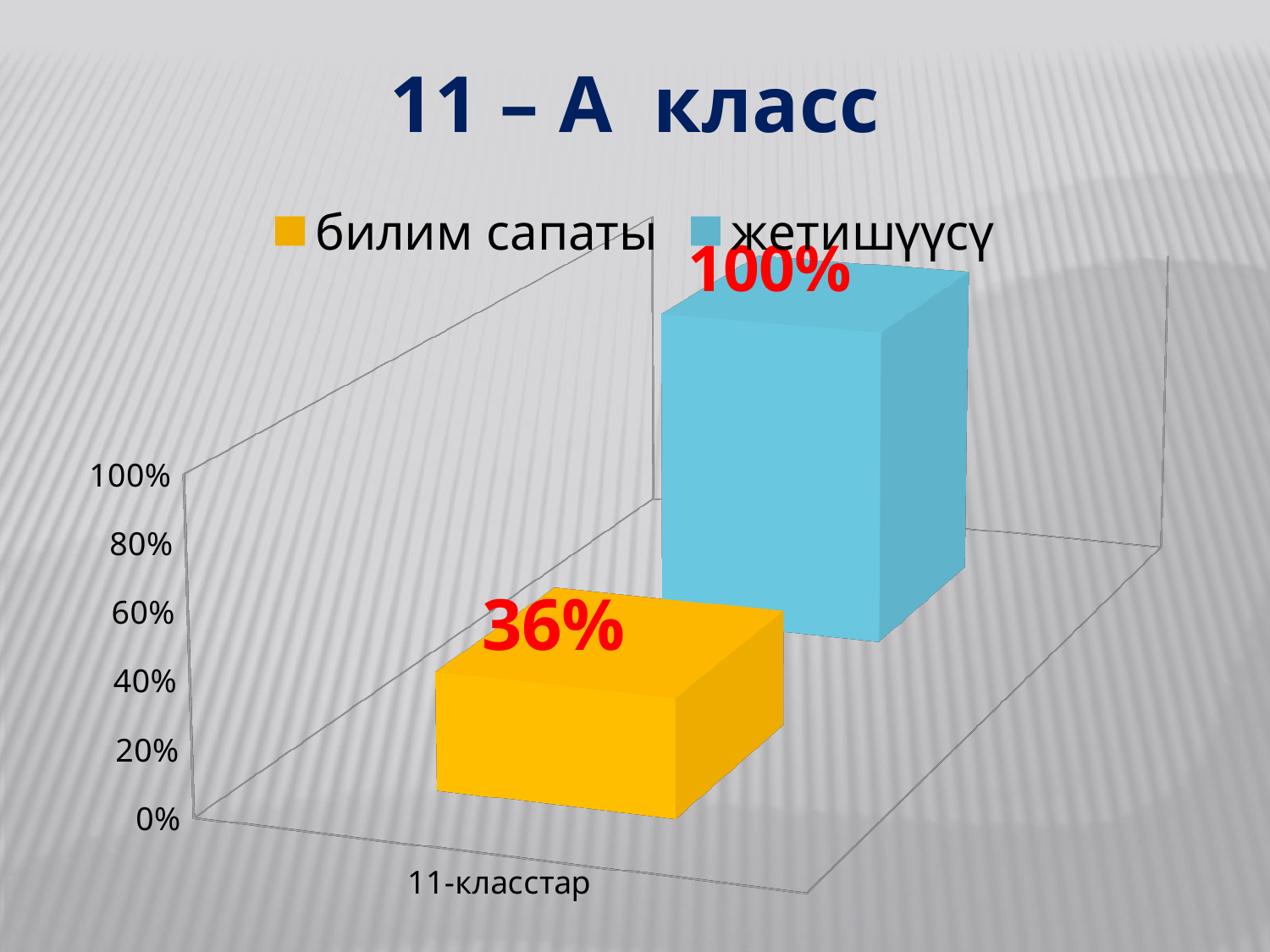
Which series has the higher value, билим сапаты or жетишүүсү? жетишүүсү Is the value for жетишүүсү greater or less than 80%? greater What is the value for билим сапаты? 36% What is the value for жетишүүсү? 100% What kind of chart is shown on the slide? bar chart Is the value for билим сапаты greater or less than 40%? less What is the category label on the x axis? 11-класстар How many series does the legend list? 2 What is the difference between the values for жетишүүсү and билим сапаты? 64% What is the title of the slide? 11 – А класс How many categories are shown on the x axis? 1 Which series has the lowest value? билим сапаты